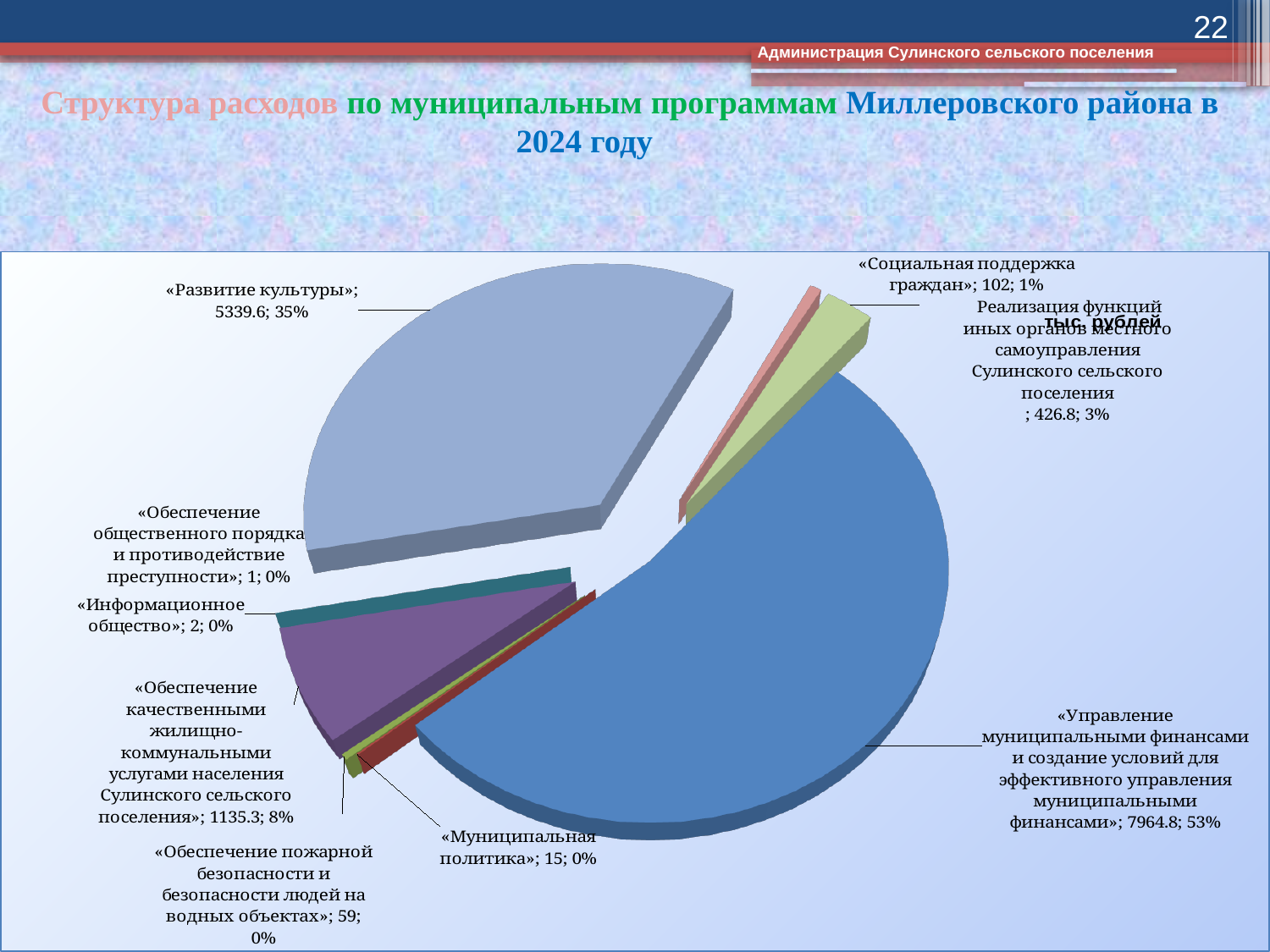
What kind of chart is shown on the slide? pie chart Which is larger: the value for «Муниципальная политика» or the value for «Обеспечение пожарной безопасности и безопасности людей на водных объектах»? «Обеспечение пожарной безопасности и безопасности людей на водных объектах» What is the value for «Социальная поддержка граждан»? 102 What share of the pie does «Реализация функций иных органов местного самоуправления Сулинского сельского поселения» represent? 3% Which category has the smallest value? «Обеспечение общественного порядка и противодействие преступности» What is the value for «Обеспечение качественными жилищно-коммунальными услугами населения Сулинского сельского поселения»? 1135.3 What share of the pie does «Развитие культуры» represent? 35% What is the value for «Развитие культуры»? 5339.6 How many slices (categories) does the pie chart have? 9 What is the difference between the values for «Управление муниципальными финансами...» (7964.8) and «Развитие культуры» (5339.6)? 2625.2 What is the value for «Управление муниципальными финансами и создание условий для эффективного управления муниципальными финансами»? 7964.8 Which category has the largest share of the pie? «Управление муниципальными финансами и создание условий для эффективного управления муниципальными финансами»